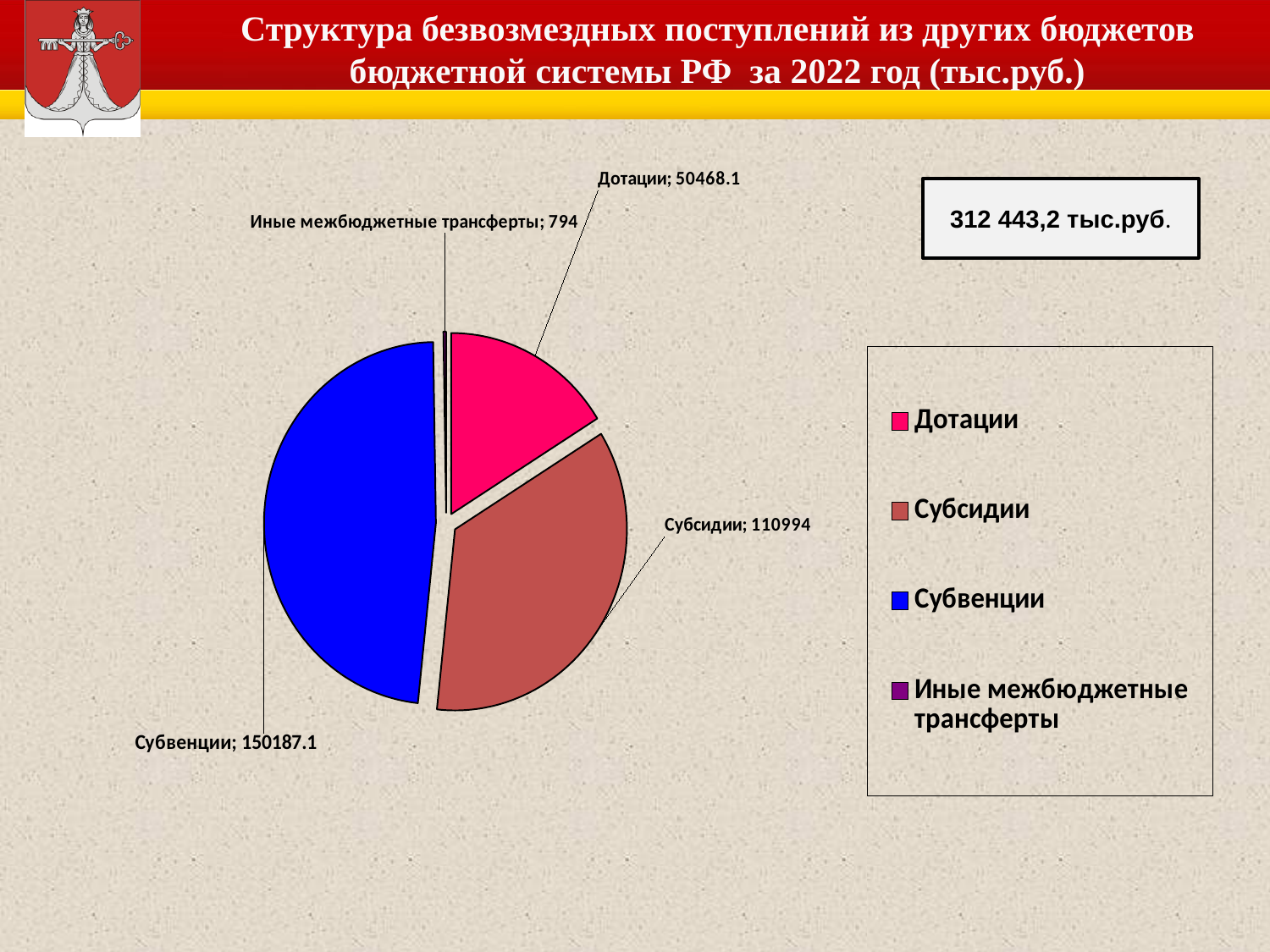
How many categories does the legend list? 4 What is the value for Дотации? 50468.1 Which category has the smallest slice of the pie? Иные межбюджетные трансферты What is the difference between the values for Субсидии and Дотации? 60525.9 What total amount is shown in the box to the right of the chart? 312 443,2 тыс.руб. Which category has the largest slice of the pie? Субвенции What is the difference between the values for Субвенции and Субсидии? 39193.1 What kind of chart is shown on the slide? pie chart What is the value for Субвенции? 150187.1 Which is larger, Дотации or Субсидии? Субсидии What is the value for Субсидии? 110994 What is the value for Иные межбюджетные трансферты? 794